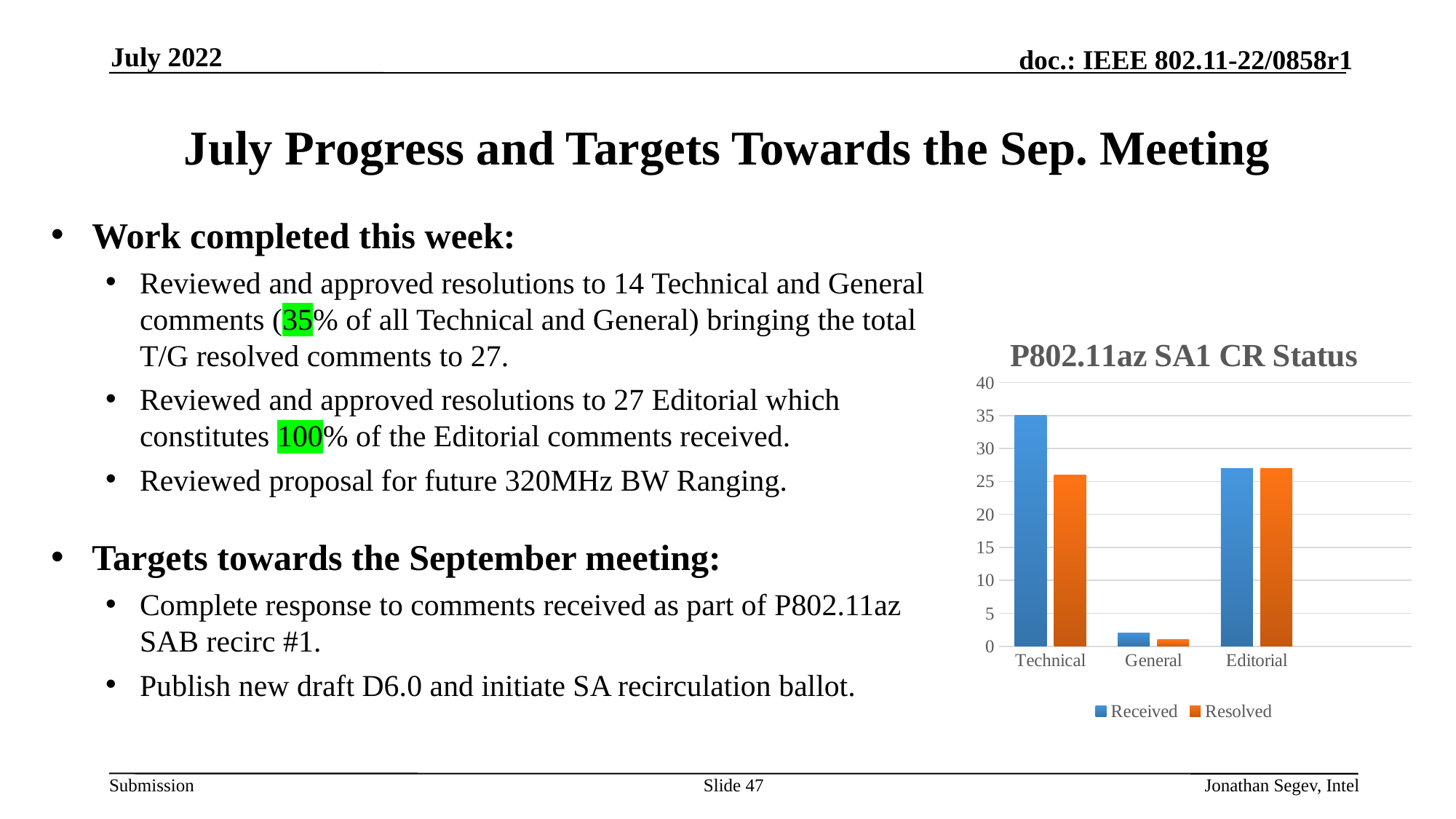
How many categories are shown on the x axis of the chart? 3 Is the Resolved value for Technical greater or less than 30? less Which category has the highest Received value? Technical For the Technical category, which is larger: Received or Resolved? Received How many series does the chart legend list? 2 Is the Received value for General greater or less than 5? less What type of chart is shown on the slide? bar chart Which category has the lowest Received value? General Which category has the lowest Resolved value? General Is the Received value for Technical greater or less than 30? greater Which series is shown in orange in the chart? Resolved What is the title of the chart on the slide? P802.11az SA1 CR Status